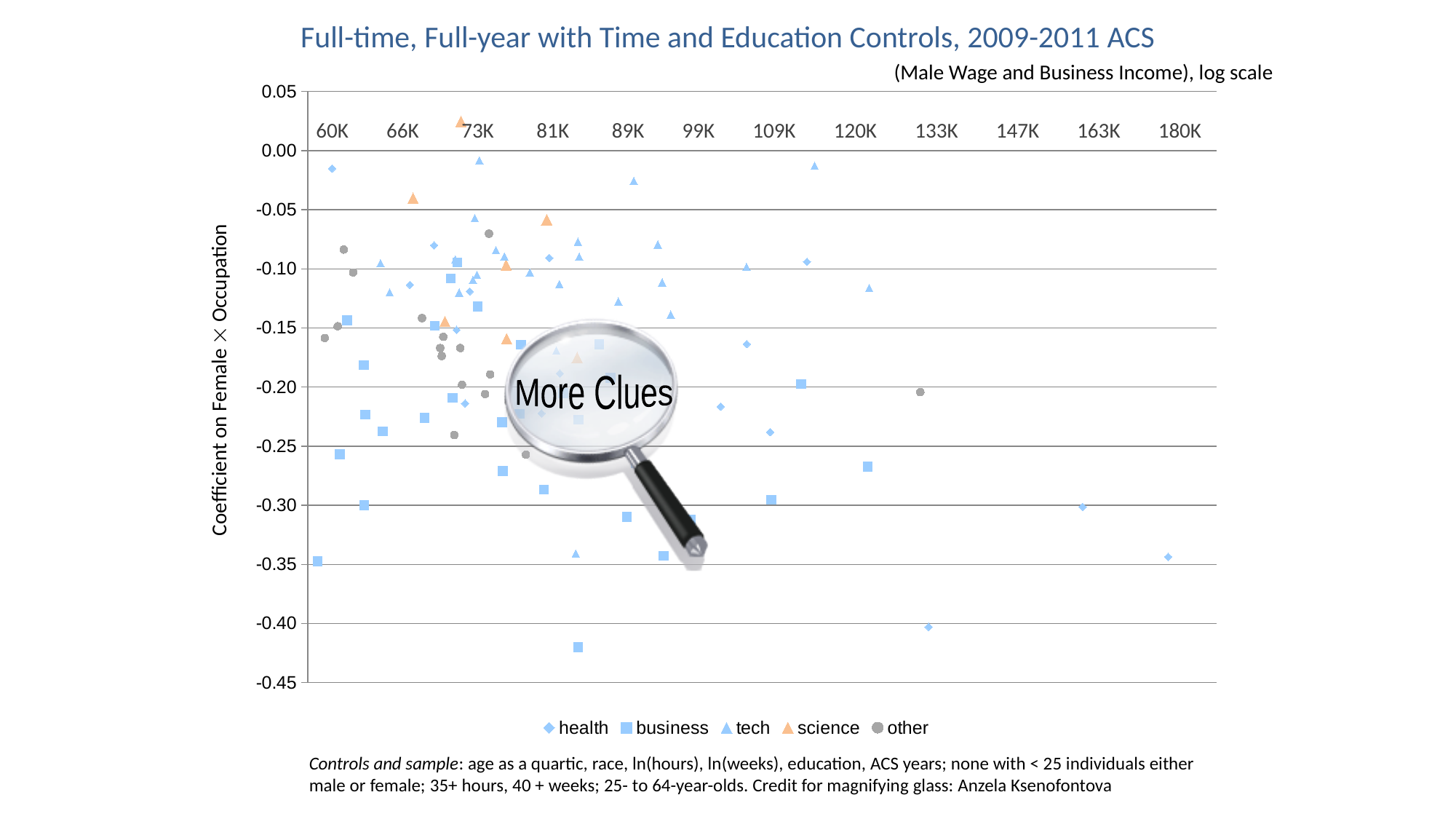
How many series does the legend list? 5 Is the lowest 'other' point on the chart greater or less than -0.30? greater What is the title of the chart? Full-time, Full-year with Time and Education Controls, 2009-2011 ACS Is the lowest health point on the chart greater or less than -0.45? greater Is the highest tech point on the chart greater or less than -0.05? greater What kind of chart is shown on the slide? scatter chart Which series are listed in the legend? health, business, tech, science, other